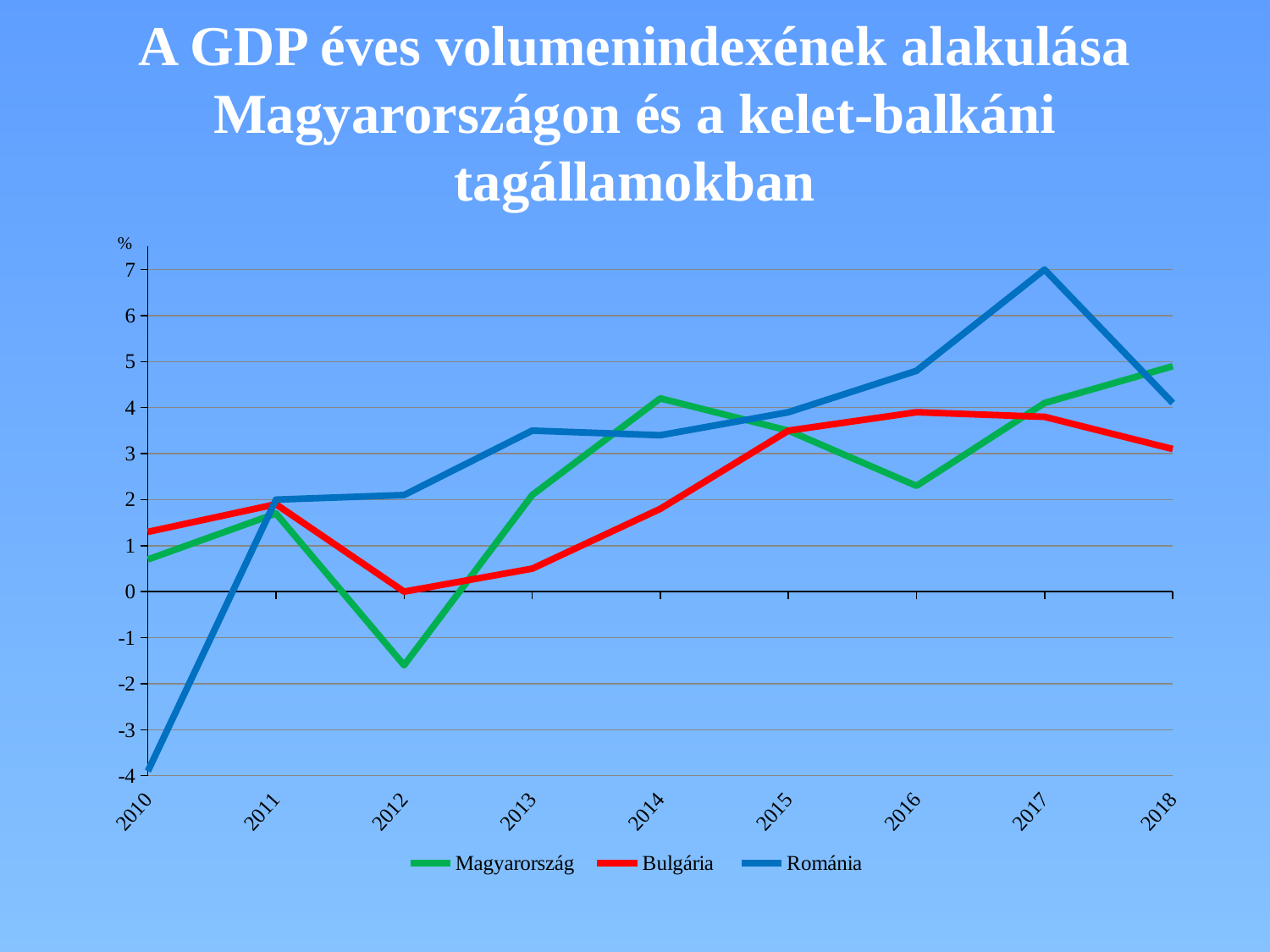
Is the value for Bulgária in 2010 greater or less than 2? less In 2018, which is larger: the value for Magyarország or the value for Románia? Magyarország What kind of chart is shown on the slide? line chart Is the value for Magyarország in 2012 greater or less than 0? less How many series does the legend list? 3 In which year does the Románia line reach its lowest value? 2010 Which series has the lowest value in 2010? Románia Is the value for Románia in 2017 greater or less than 6? greater How many years are shown on the x axis? 9 Does the Bulgária line rise or fall from 2012 to 2016? rise In which year does the Románia line reach its highest value? 2017 In 2014, which is larger: the value for Magyarország or the value for Bulgária? Magyarország